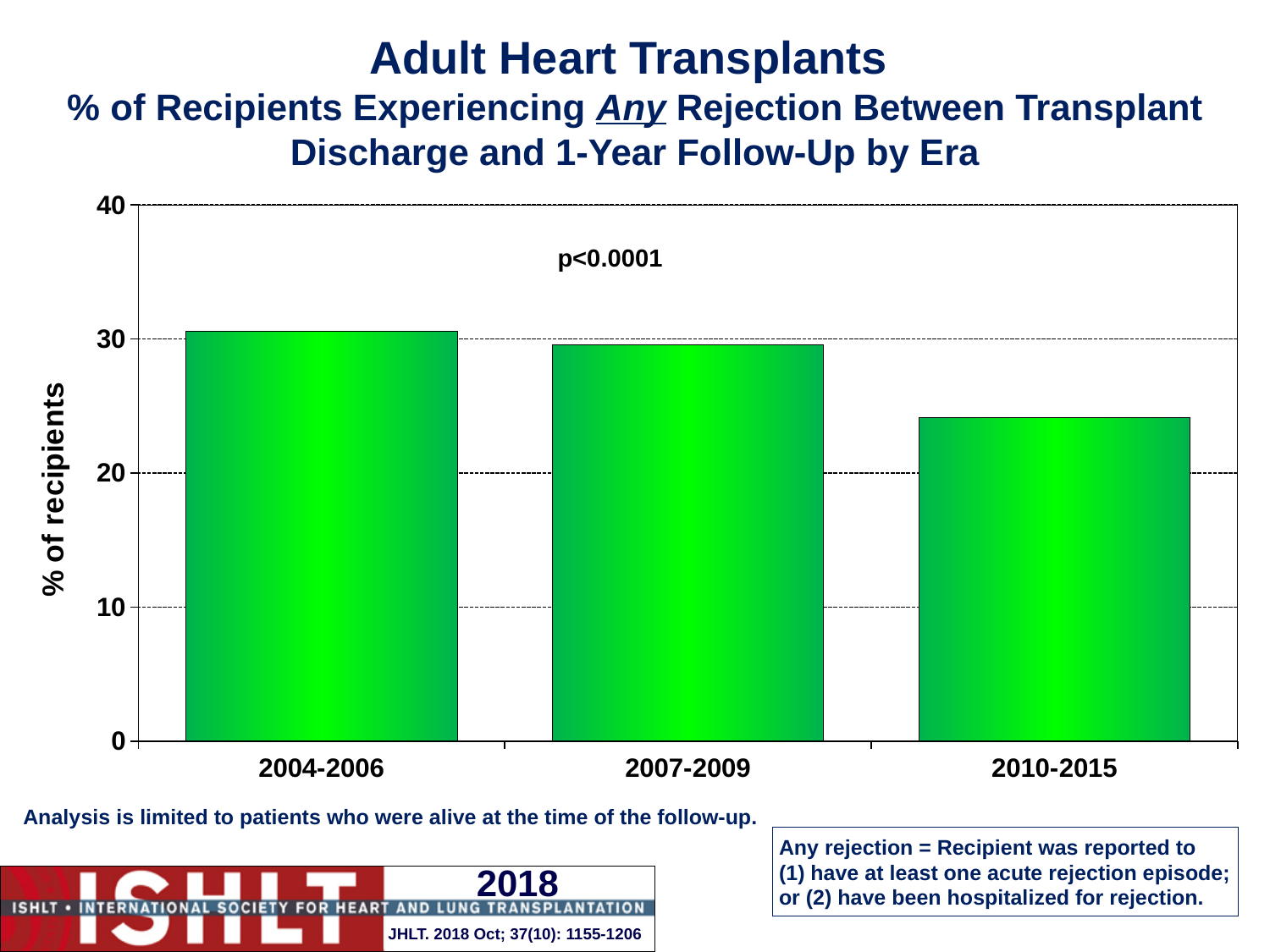
Do the values rise or fall across the eras from 2004-2006 to 2010-2015? fall Which era has the highest % of recipients experiencing any rejection? 2004-2006 Which is larger, the value for 2007-2009 or the value for 2010-2015? 2007-2009 What is the label on the y axis? % of recipients How many era categories are shown on the x axis? 3 Which era has the lowest % of recipients experiencing any rejection? 2010-2015 Is the value for 2007-2009 greater or less than 30? less What kind of chart is shown on the slide? bar chart Is the value for 2010-2015 greater or less than 30? less Is the value for 2004-2006 greater or less than 30? greater What p-value is printed on the chart? p<0.0001